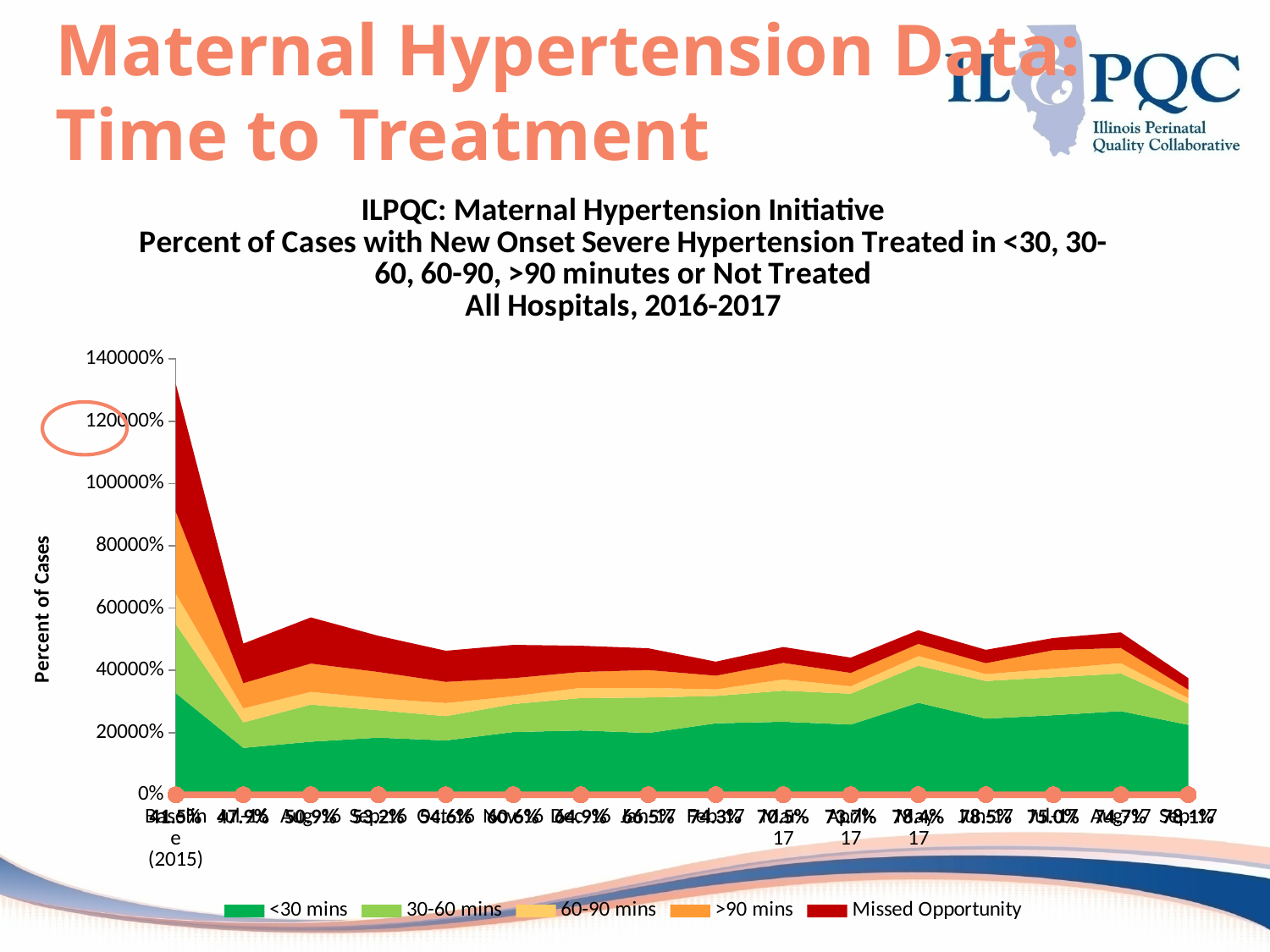
Is the stacked total at the last point on the x axis greater or less than 60000%? less Does the stacked total rise or fall between the first and second points on the x axis? Fall What is the label on the vertical axis? Percent of Cases What kind of chart is shown on the slide? Stacked area chart Is the stacked total at the first point on the x axis greater or less than 120000%? greater How many series does the legend list? 5 Which series is shown in red at the top of the stack? Missed Opportunity How many data points are plotted along the x axis? 16 Which series is plotted at the bottom of the stacked area chart? <30 mins Is the stacked total at the second point on the x axis greater or less than 80000%? less Which point along the x axis has the highest stacked total? The first point (Baseline 2015) What is the highest tick value shown on the vertical axis? 140000%